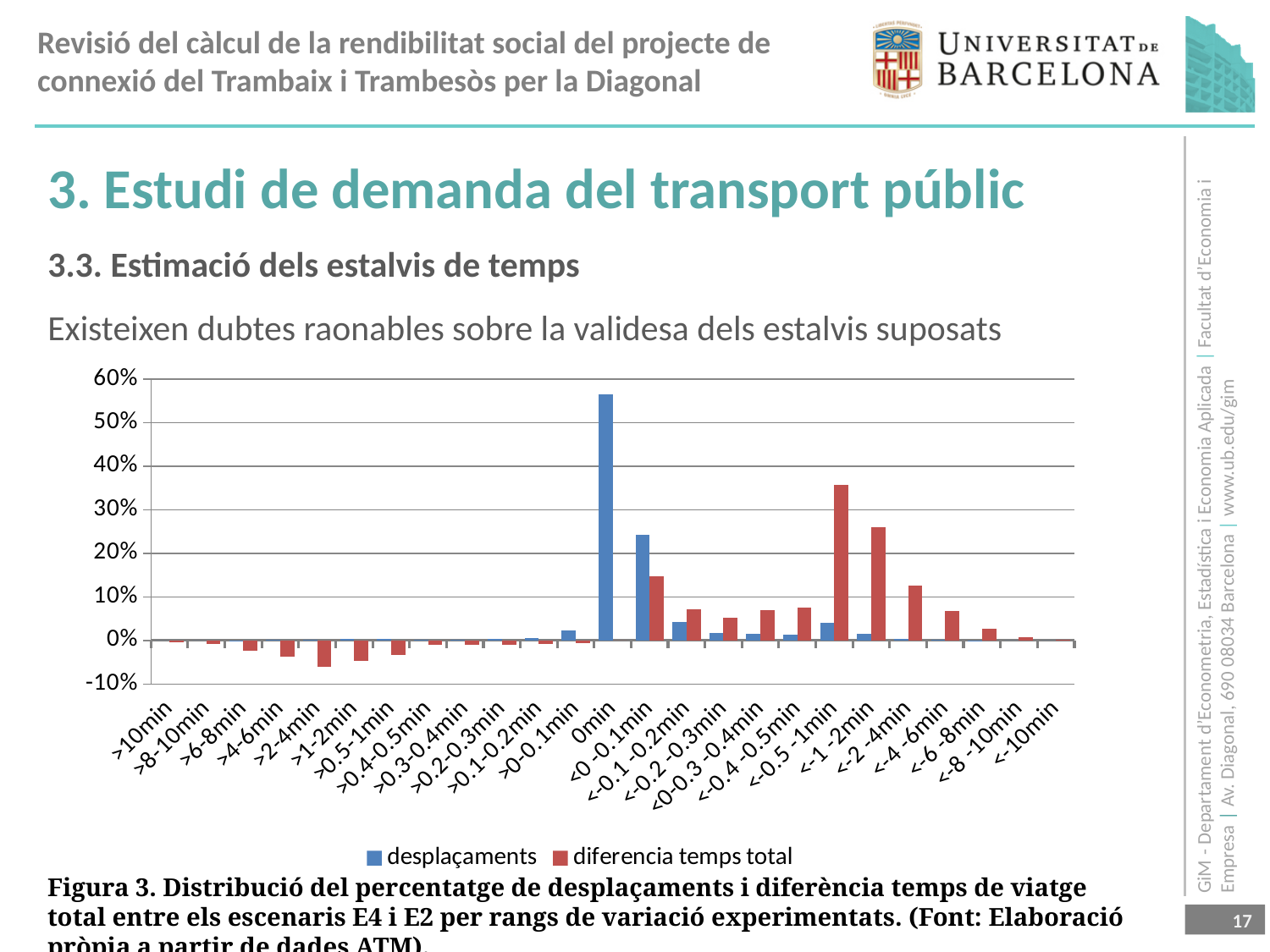
How many categories are shown along the x axis? 25 Is the diferencia temps total value for <-2 -4min greater or less than 20%? less For the diferencia temps total series, which is larger: <-1 -2min or <-2 -4min? <-1 -2min Is the diferencia temps total value for <-0.5 -1min greater or less than 30%? greater Is the desplaçaments value for 0min greater or less than 50%? greater What kind of chart is shown on the slide? bar chart Which category has the highest value for the diferencia temps total series? <-0.5 -1min Which category has the highest value for the desplaçaments series? 0min How many series does the legend list? 2 For the desplaçaments series, which is larger: 0min or <0 -0.1min? 0min What colour are the bars for the desplaçaments series? blue